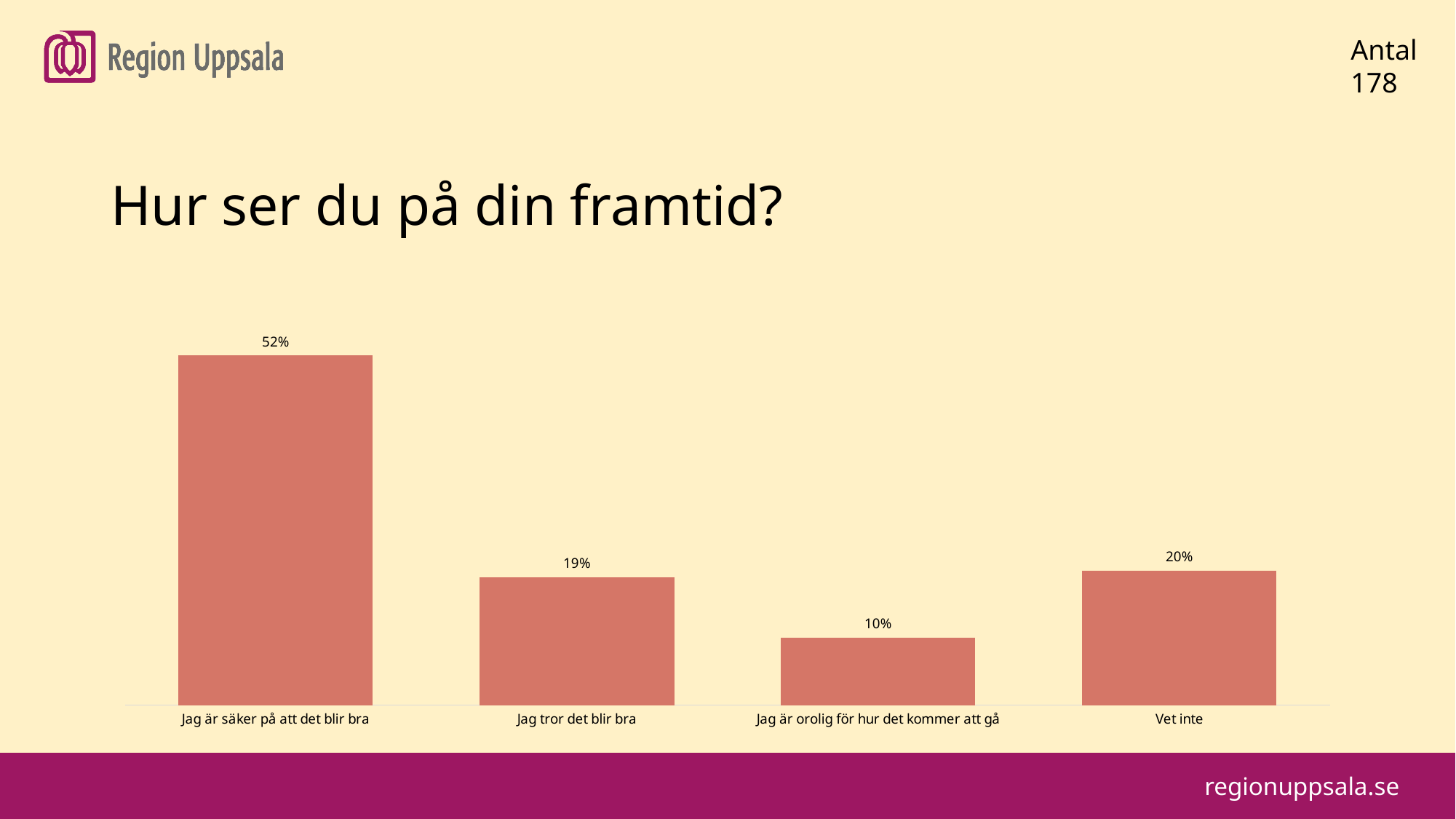
What is the difference between the values for "Jag tror det blir bra" and "Jag är orolig för hur det kommer att gå"? 9% What is the value for "Jag är orolig för hur det kommer att gå"? 10% What is the difference between the values for "Jag är säker på att det blir bra" and "Vet inte"? 32% How many categories are shown in the chart? 4 What is the value for "Jag tror det blir bra"? 19% Which category has the lowest value? Jag är orolig för hur det kommer att gå What is the value for "Jag är säker på att det blir bra"? 52% Which category has the highest value? Jag är säker på att det blir bra What is the value for "Vet inte"? 20% Which is larger, the value for "Jag tror det blir bra" or the value for "Jag är orolig för hur det kommer att gå"? Jag tror det blir bra What kind of chart is shown on the slide? Bar chart What is the title of the slide above the chart? Hur ser du på din framtid?